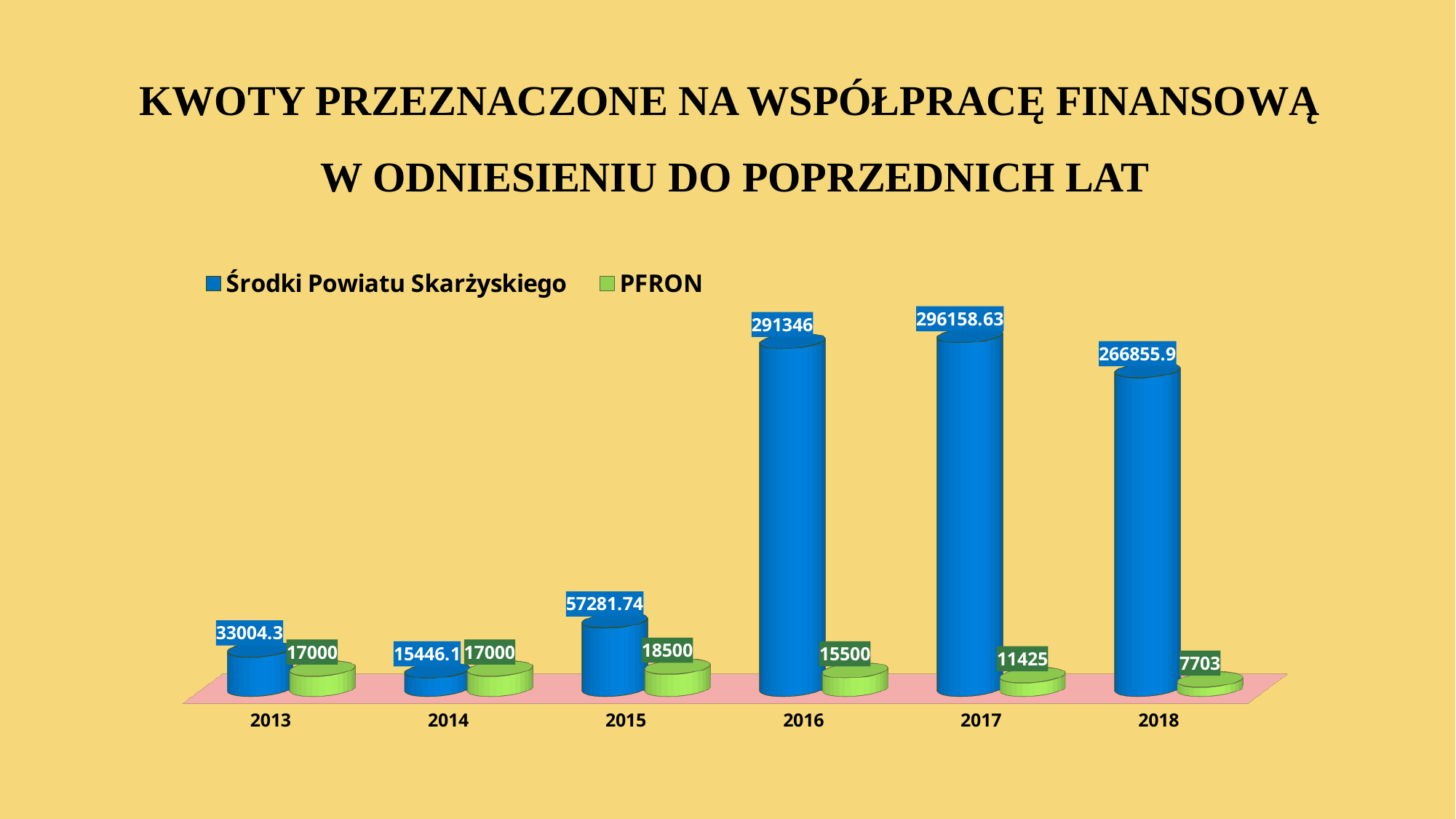
How many years are shown on the x axis? 6 In which year is the Środki Powiatu Skarżyskiego value highest? 2017 What is the value for Środki Powiatu Skarżyskiego in 2015? 57281.74 In which year is the PFRON value lowest? 2018 In which year is the PFRON value highest? 2015 What is the value for Środki Powiatu Skarżyskiego in 2016? 291346 What is the difference between the PFRON values for 2015 and 2018? 10797 What is the PFRON value for 2017? 11425 Does the PFRON value rise or fall from 2015 to 2018? fall What is the difference between the Środki Powiatu Skarżyskiego values for 2017 and 2016? 4812.63 Which is larger in 2014: Środki Powiatu Skarżyskiego or PFRON? PFRON How many series does the legend list? 2